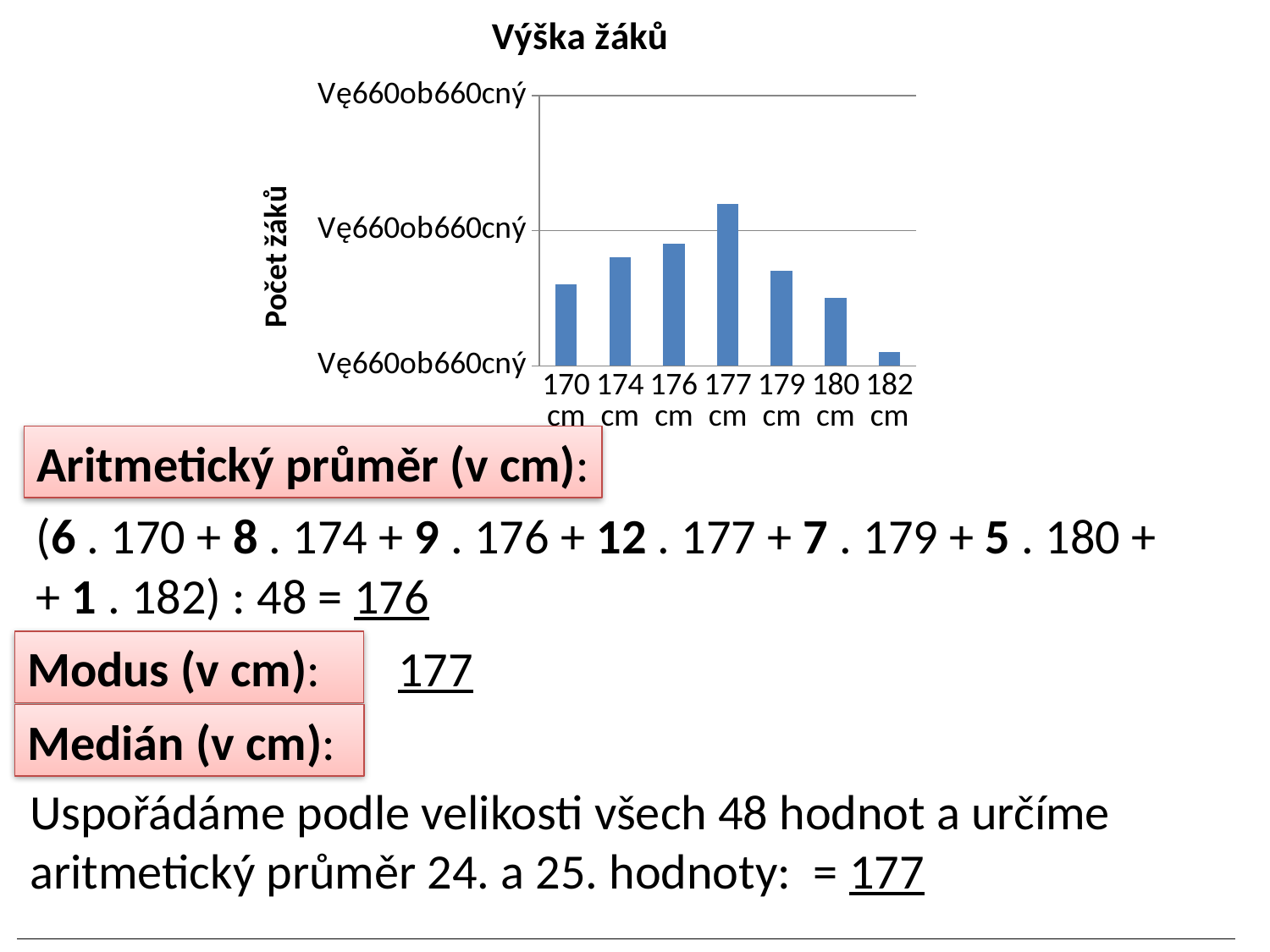
Which bar is taller in the chart, 180 cm or 182 cm? 180 cm What is the title of the chart? Výška žáků Do the bar heights rise or fall from 177 cm to 182 cm along the x axis? fall Do the bar heights rise or fall from 170 cm to 177 cm along the x axis? rise Which height category has the shortest bar in the chart? 182 cm How many height categories are shown on the x axis of the chart? 7 What kind of chart is shown on the slide? bar chart Which height category has the tallest bar in the chart? 177 cm What is the label of the vertical axis of the chart? Počet žáků Which bar is taller in the chart, 176 cm or 177 cm? 177 cm Which bar is taller in the chart, 170 cm or 176 cm? 176 cm